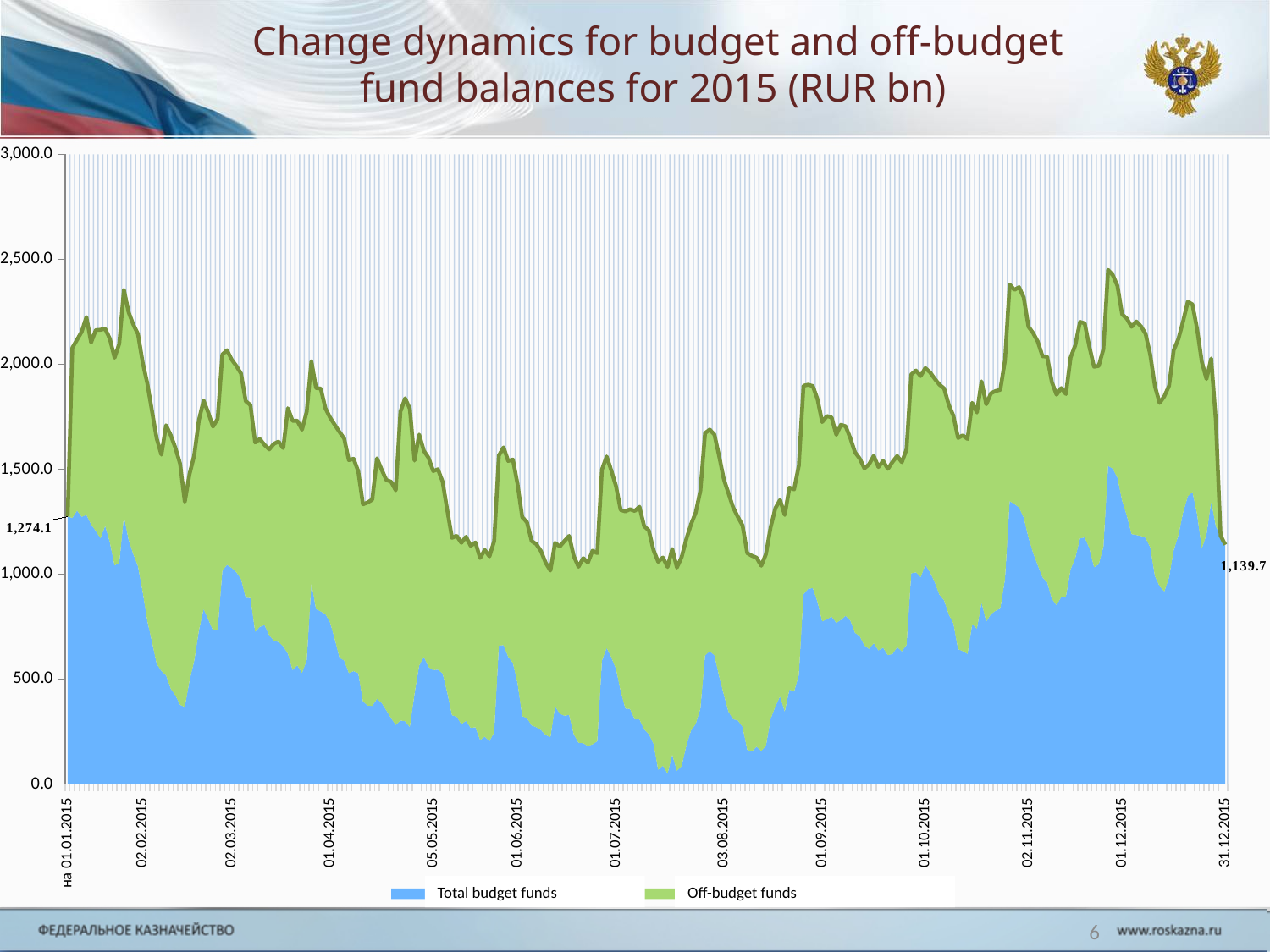
What is the title of the chart? Change dynamics for budget and off-budget fund balances for 2015 (RUR bn) What are the two series named in the legend? Total budget funds and Off-budget funds How many series does the legend list? 2 Is the value for Total budget funds around 01.07.2015 greater or less than 1,000.0? less What value is labelled on the chart at 31.12.2015? 1,139.7 What kind of chart is shown on the slide? Area chart How many date labels are shown on the x axis? 13 What value is labelled on the chart at 01.01.2015? 1,274.1 What is the difference between the labelled value at 01.01.2015 (1,274.1) and the labelled value at 31.12.2015 (1,139.7)? 134.4 Which labelled value is larger: the one at 01.01.2015 or the one at 31.12.2015? 01.01.2015 What is the highest value shown on the y axis? 3,000.0 Is the combined top of the stacked areas around 01.12.2015 greater or less than 2,000.0? greater